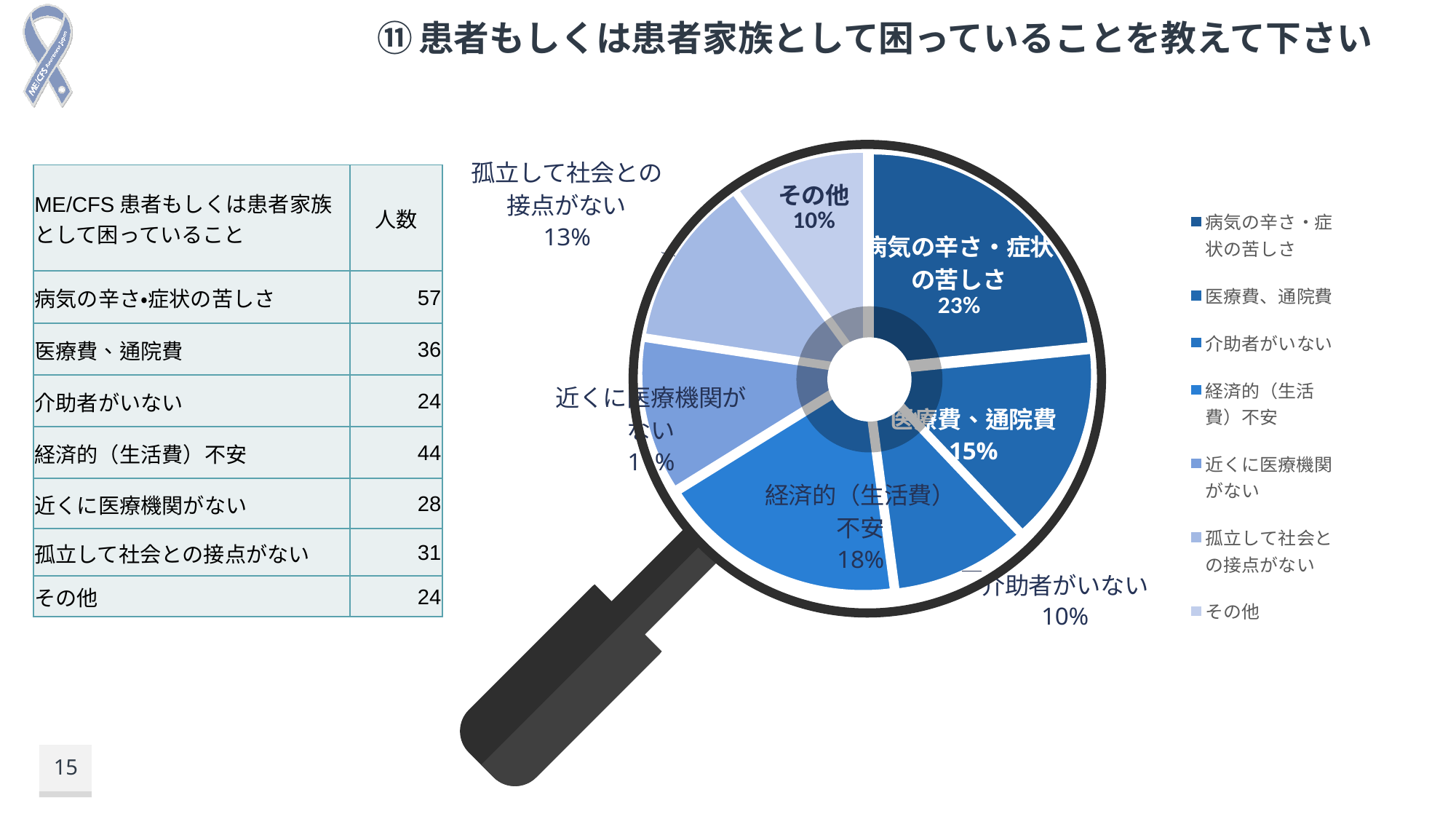
What percentage of the pie chart is その他? 10% What kind of chart is shown on the slide? pie chart How many slices does the pie chart have? 7 What percentage of the pie chart is 病気の辛さ・症状の苦しさ? 23% Which category has the largest slice in the pie chart? 病気の辛さ・症状の苦しさ What percentage of the pie chart is 介助者がいない? 10% What percentage of the pie chart is 経済的（生活費）不安? 18% Which slice is larger in the pie chart: 経済的（生活費）不安 or 医療費、通院費? 経済的（生活費）不安 What percentage of the pie chart is 医療費、通院費? 15% What percentage of the pie chart is 孤立して社会との接点がない? 13% What is the difference in percentage points between 病気の辛さ・症状の苦しさ and 医療費、通院費 in the pie chart? 8 How many entries does the pie chart's legend list? 7